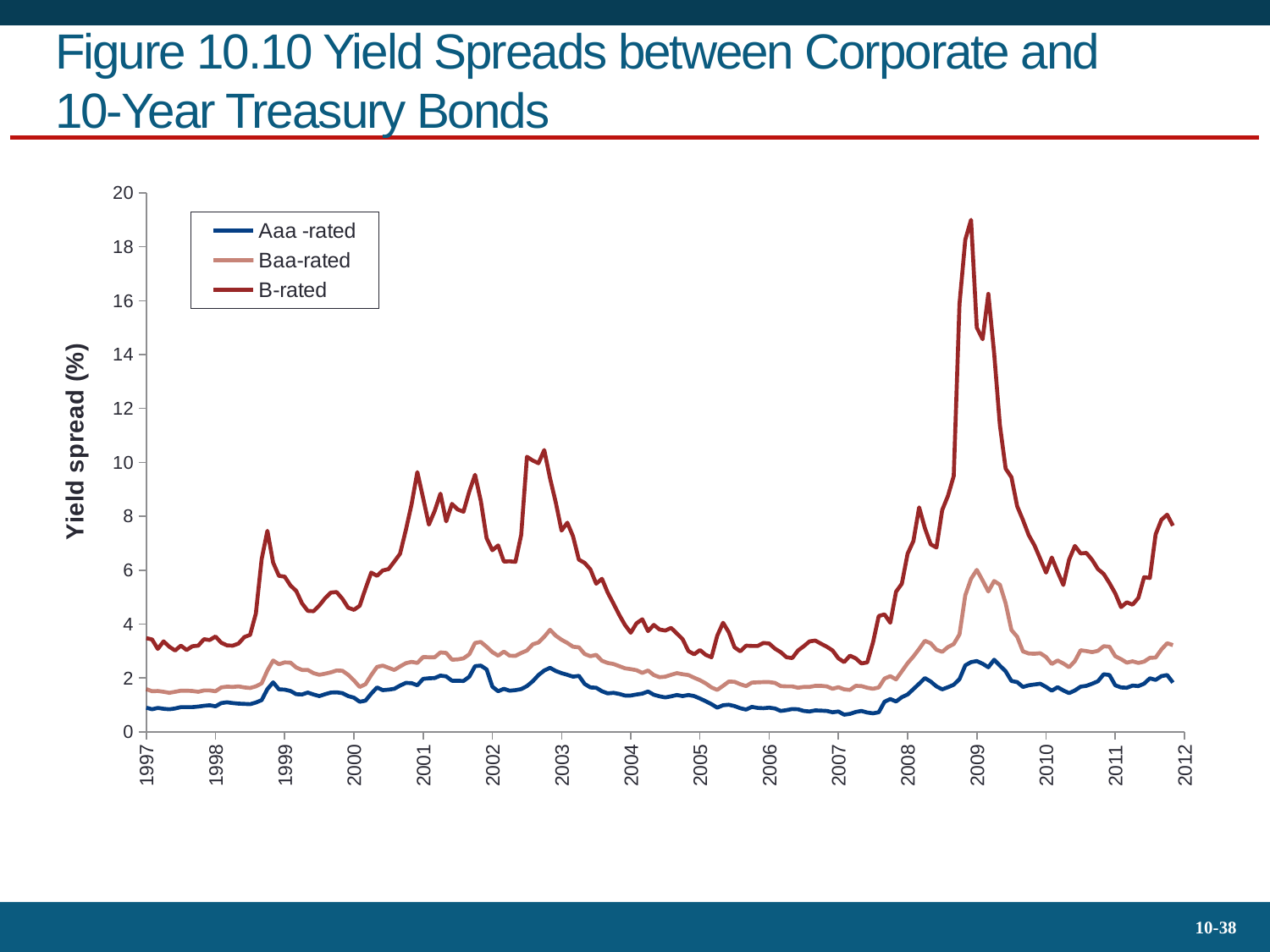
Is the peak value of the B-rated series around 2009 greater or less than 16? greater Does the B-rated yield spread rise or fall between 2007 and early 2009? rise What kind of chart is shown on the slide? Line chart Around 2009, which is larger: the B-rated yield spread or the Aaa-rated yield spread? B-rated What is the label on the vertical axis? Yield spread (%) Which series has the lowest yield spread throughout the chart? Aaa-rated What are the three series named in the legend? Aaa-rated, Baa-rated, B-rated How many series does the legend list? 3 Which series reaches the highest yield spread on the chart? B-rated Is the value for the Aaa-rated series in 2007 greater or less than 2? less How many years are labeled on the horizontal axis? 16 Is the peak value of the Baa-rated series around 2009 greater or less than 4? greater